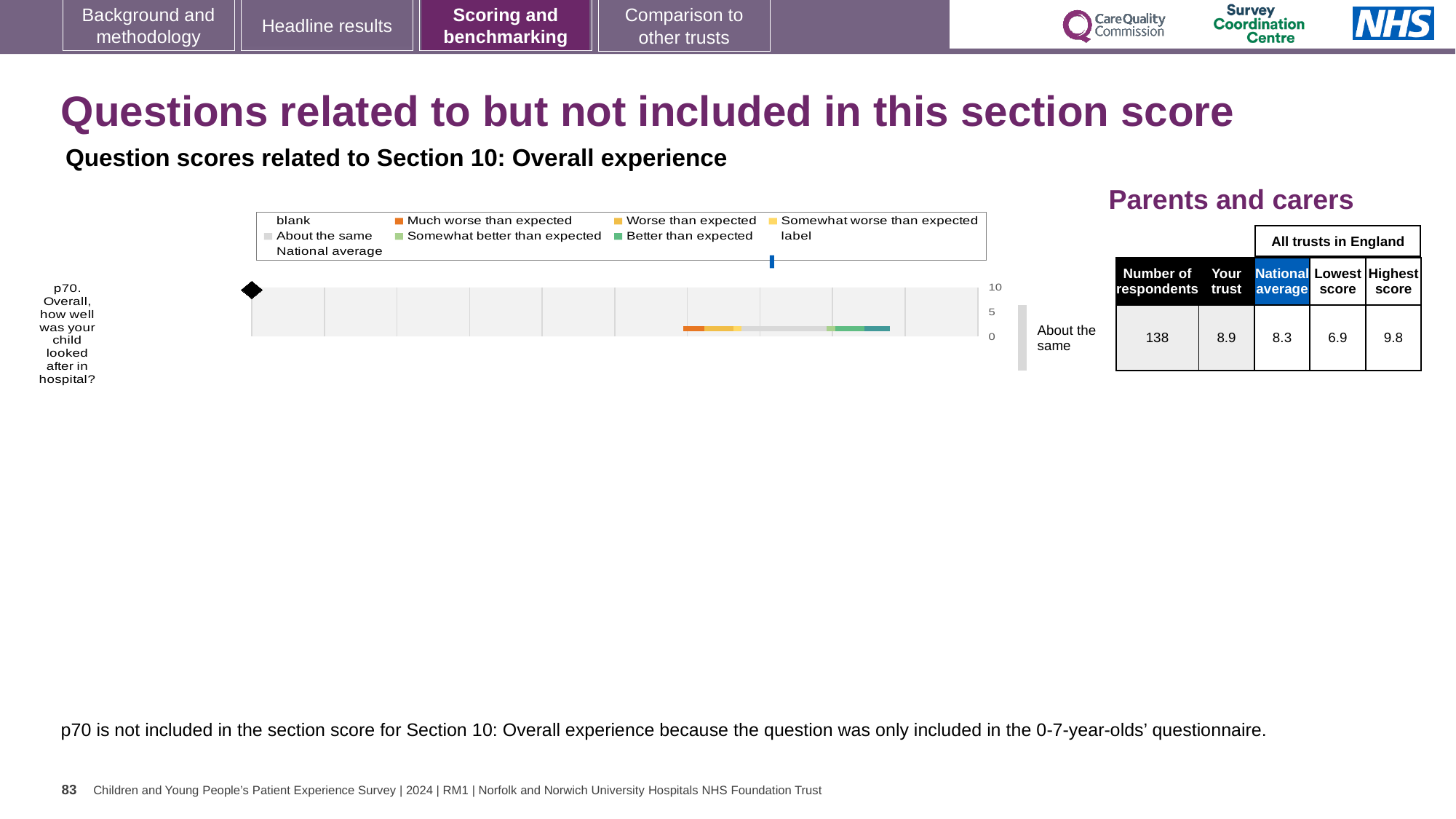
What is the highest tick value shown on the chart's axis? 10 What benchmarking category label is shown to the right of the bar for p70? About the same What kind of chart is used to show the benchmarking result for question p70? Bar chart In the table beside the chart, how many respondents answered p70? 138 In the table beside the chart, what is the lowest score among all trusts in England for p70? 6.9 For p70, what is the difference between the highest score and the lowest score among all trusts in England? 2.9 How many survey questions are plotted in the chart? 1 In the table beside the chart, what is the 'Your trust' score for p70? 8.9 Which question is plotted in the chart? p70. Overall, how well was your child looked after in hospital? In the table beside the chart, what is the national average score for p70? 8.3 In the table beside the chart, what is the highest score among all trusts in England for p70? 9.8 For p70, is the 'Your trust' score higher or lower than the national average? Higher